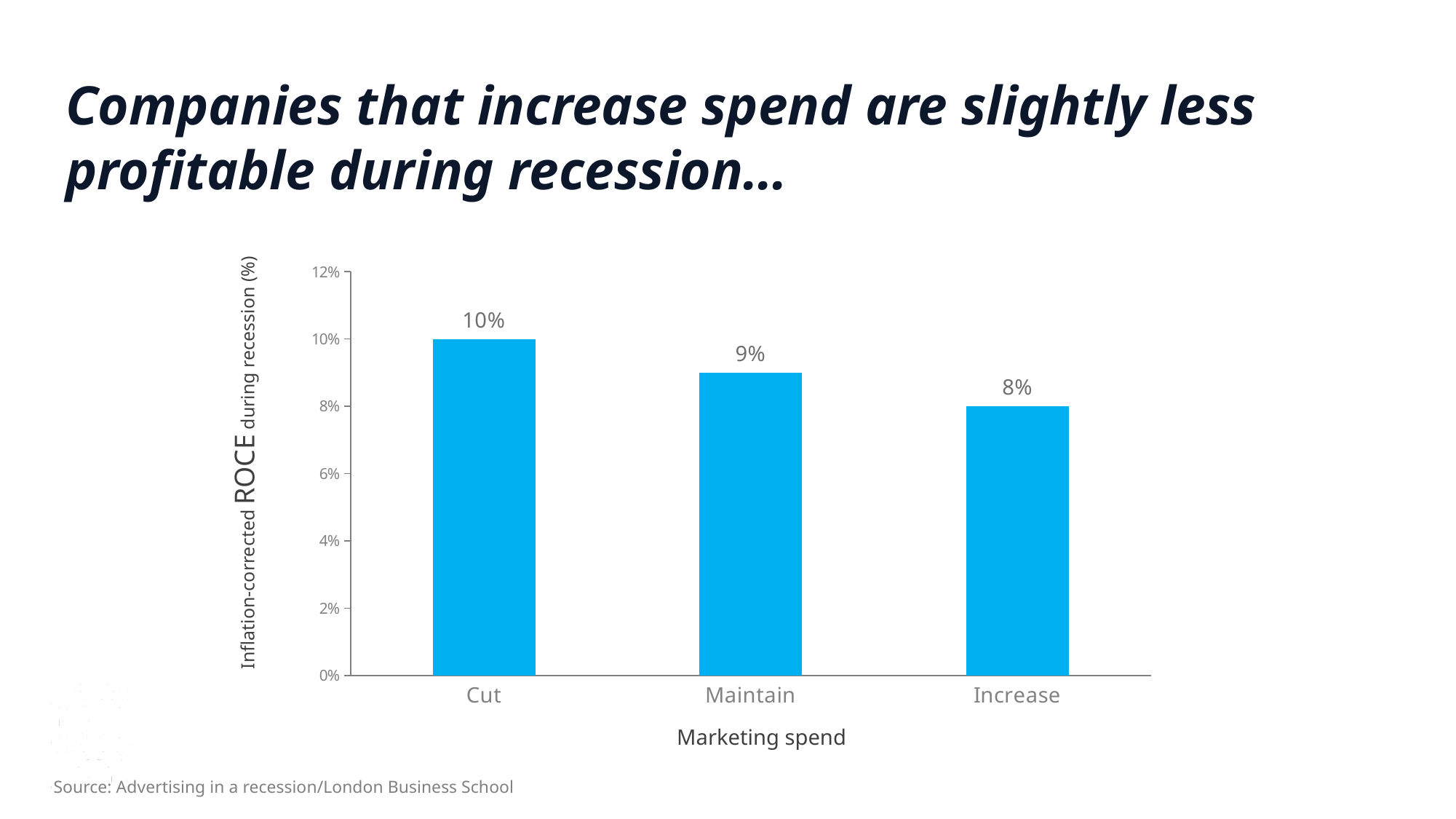
Which marketing spend category has the highest inflation-corrected ROCE during recession? Cut Is the value for Increase greater or less than 10%? less What is the inflation-corrected ROCE during recession for companies that maintain marketing spend? 9% What is the label of the x axis on the chart? Marketing spend What kind of chart is shown on the slide? Bar chart Do the values rise or fall moving from Cut to Increase along the x axis? Fall Which has a higher inflation-corrected ROCE during recession: Maintain or Increase? Maintain Which marketing spend category has the lowest inflation-corrected ROCE during recession? Increase What is the inflation-corrected ROCE during recession for companies that increase marketing spend? 8% What is the difference in inflation-corrected ROCE between the Cut and Increase categories? 2% What is the inflation-corrected ROCE during recession for companies that cut marketing spend? 10% How many marketing spend categories are shown on the chart? 3